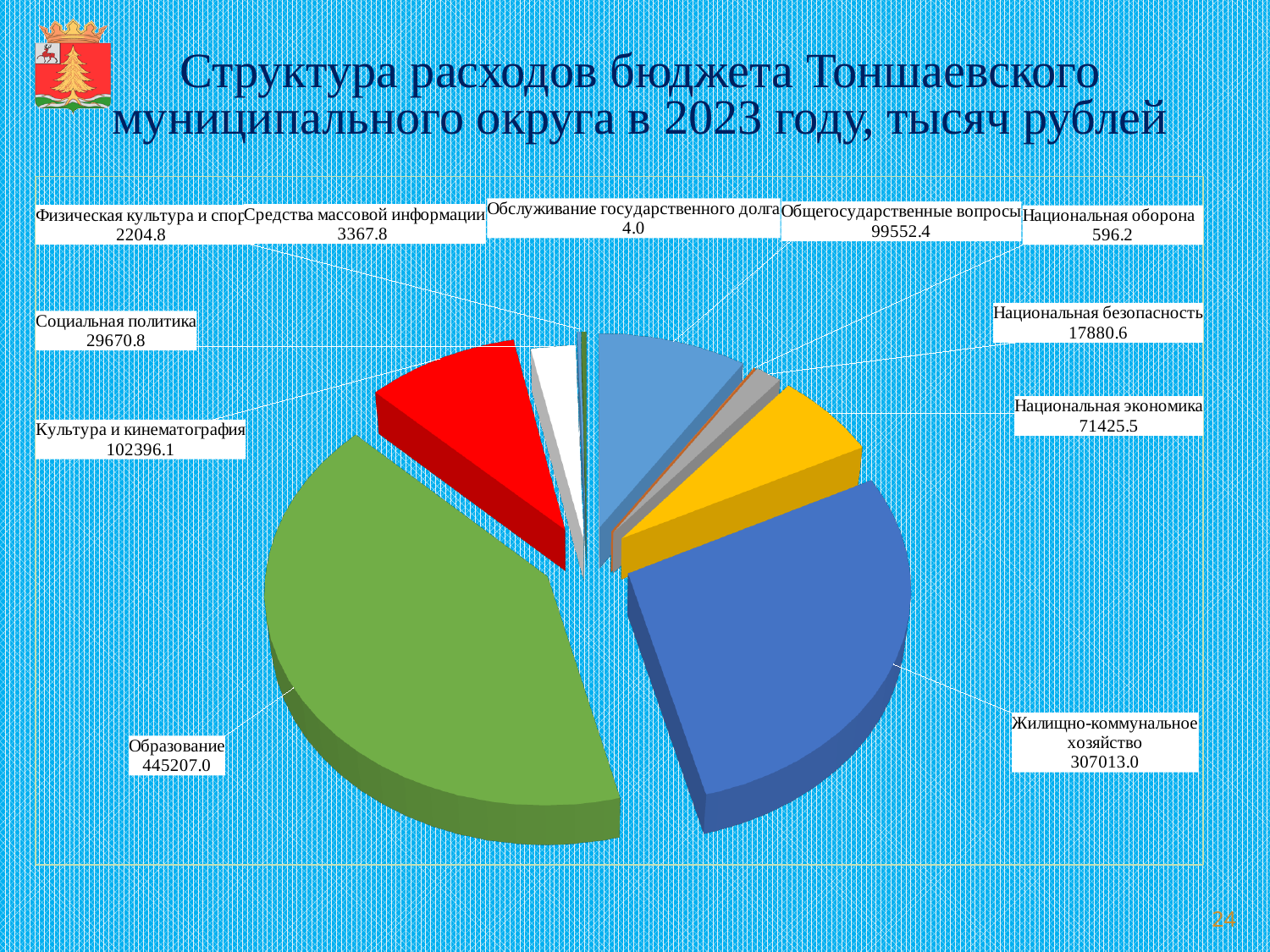
What is the value for Жилищно-коммунальное хозяйство? 307013.0 What is the value for Национальная безопасность? 17880.6 Which category has the smallest value? Обслуживание государственного долга Which is larger: Национальная экономика or Социальная политика? Национальная экономика How many categories are shown in the pie chart? 11 What is the difference between the values for Культура и кинематография and Общегосударственные вопросы? 2843.7 What is the value for Образование? 445207.0 Which category has the largest value? Образование What type of chart is shown on the slide? Pie chart What is the difference between the values for Образование and Жилищно-коммунальное хозяйство? 138194.0 What is the value for Обслуживание государственного долга? 4.0 What colour is the slice for Образование? Green